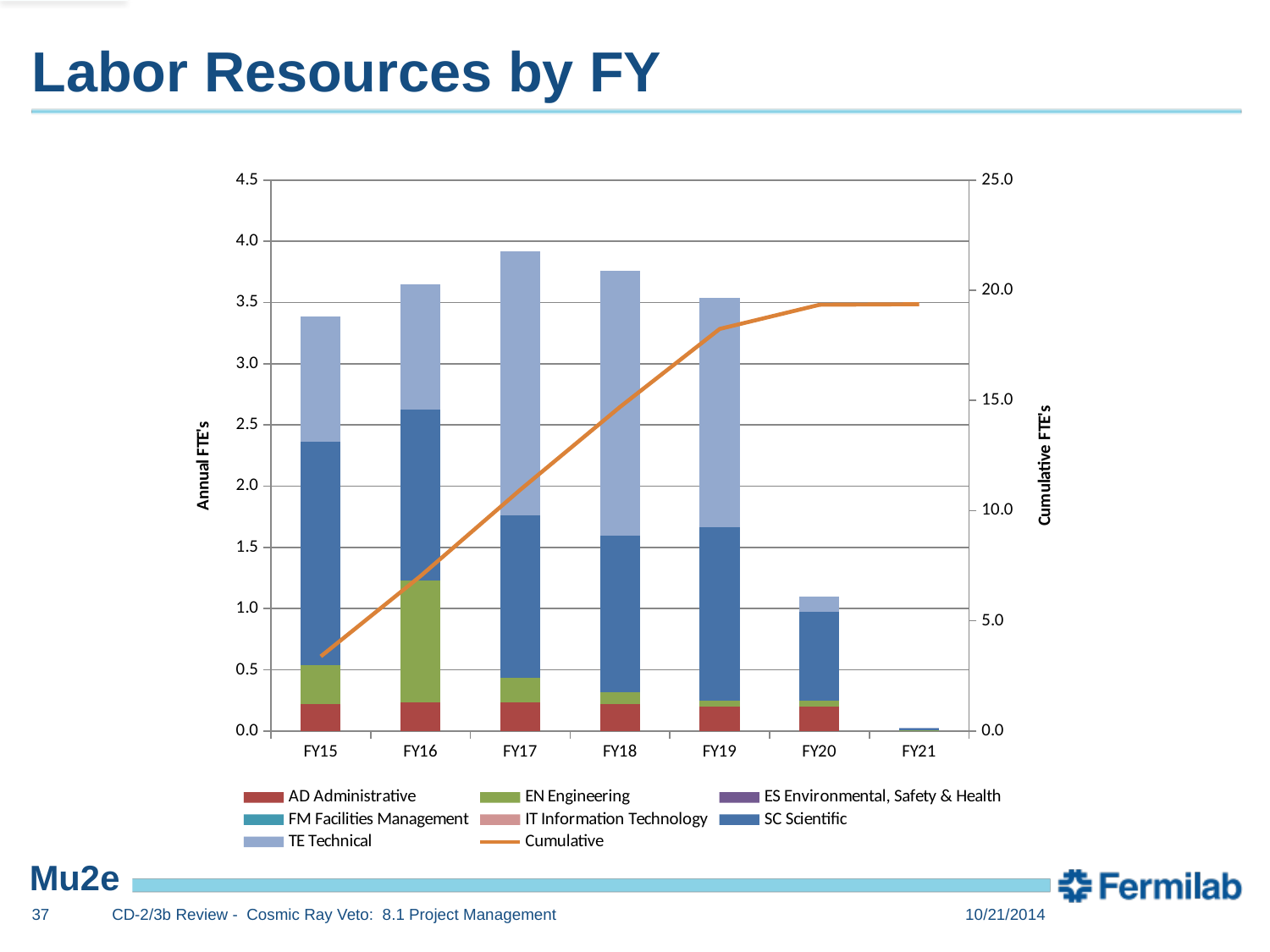
Is the total annual FTE's for FY17 greater or less than 3.5? greater In which fiscal year is the EN Engineering segment largest? FY16 Is the Cumulative FTE's value at FY15 greater or less than 5.0? less Is the Cumulative FTE's value at FY20 greater or less than 15.0? greater What is the title of the right-hand vertical axis? Cumulative FTE's What kind of chart is shown on the slide? Stacked bar chart with a line Which fiscal year has the tallest stacked bar of annual FTE's? FY17 How many series does the legend list? 8 Which has the larger total annual FTE's, FY18 or FY20? FY18 Which fiscal year has the smallest stacked bar of annual FTE's? FY21 How many fiscal years are shown on the x axis? 7